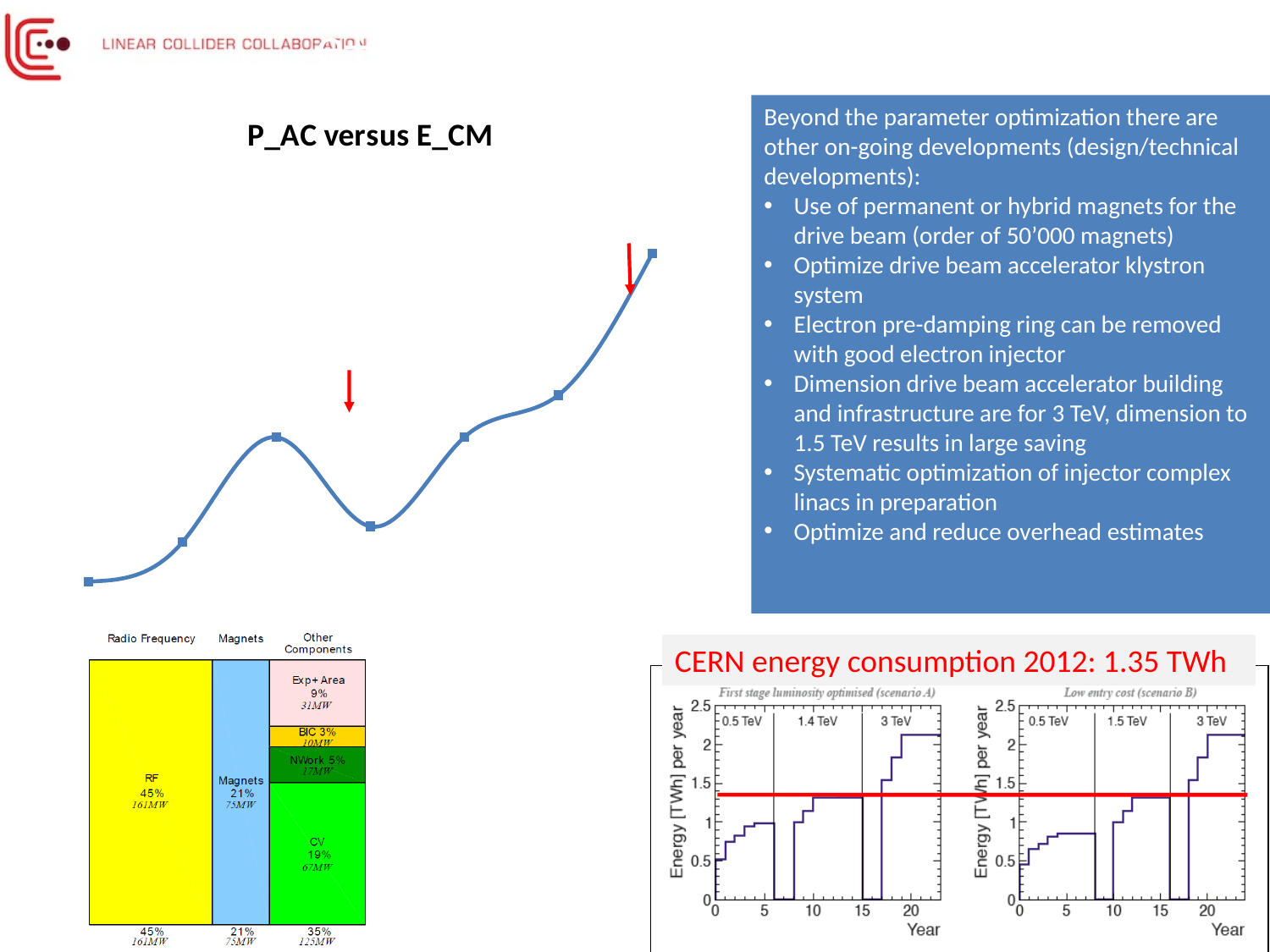
In the power breakdown chart at the bottom left, which of the Other Components has the smallest share? BIC In the power breakdown chart at the bottom left, what is the difference in percentage between RF and Magnets? 24% In the power breakdown chart at the bottom left, what is the power in MW for CV? 67MW In the power breakdown chart at the bottom left, which component has the largest share? RF What kind of chart is the 'P_AC versus E_CM' chart? line chart In the power breakdown chart at the bottom left, what percentage is attributed to RF? 45% How many data points are plotted on the 'P_AC versus E_CM' line chart? 7 In the power breakdown chart at the bottom left, what is the power in MW for Magnets? 75MW In the power breakdown chart at the bottom left, what is the total percentage for Other Components? 35% What is the title of the line chart at the top left of the slide? P_AC versus E_CM On the 'P_AC versus E_CM' chart, is the last point higher or lower than the first point? higher In the 'First stage luminosity optimised (scenario A)' energy chart at the bottom right, is the energy per year at the 3 TeV stage greater or less than 2 TWh? greater